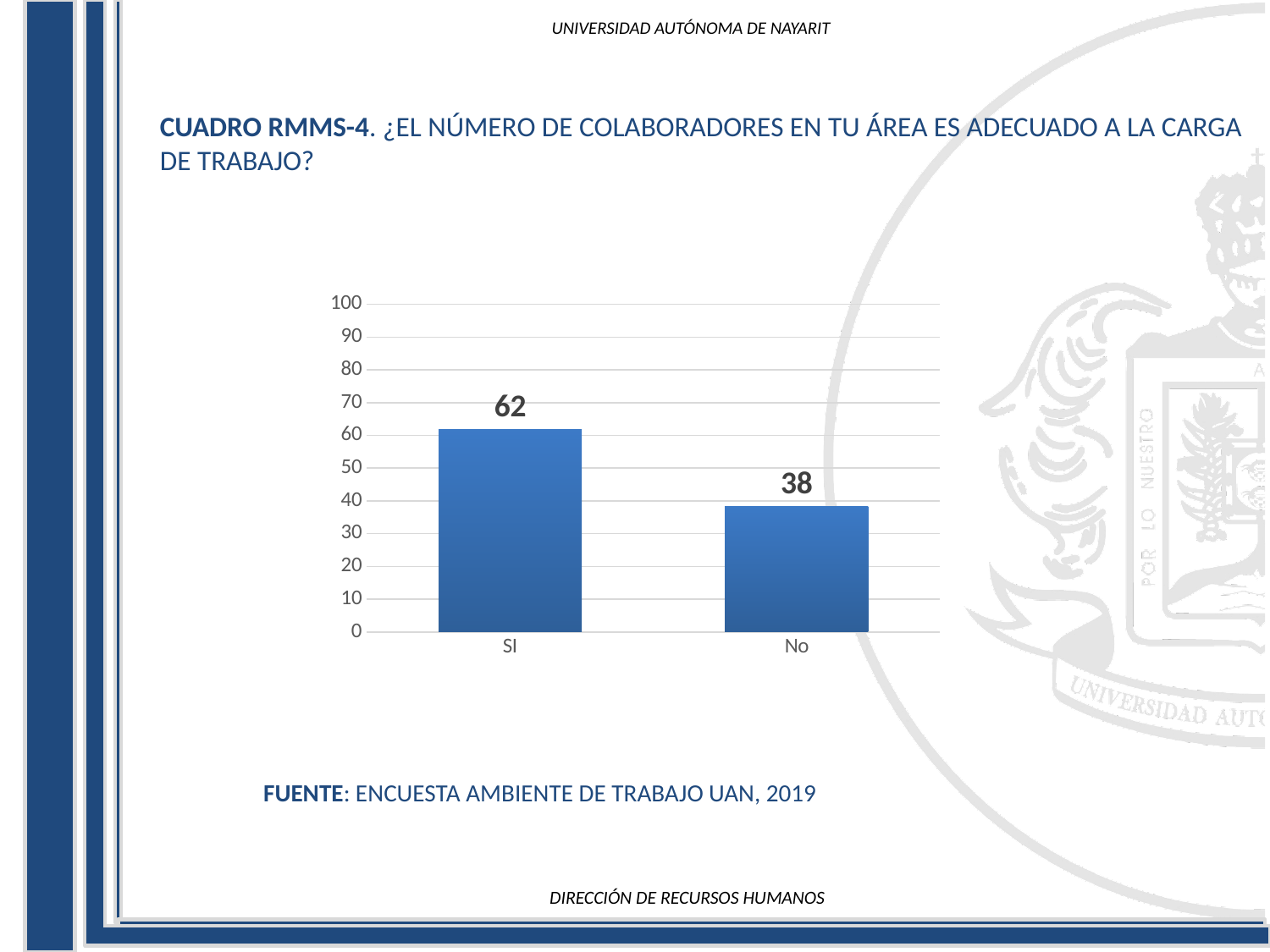
Is the value for No greater or less than 40? less What kind of chart is shown on the slide? bar chart What is the total of the two bar values? 100 Which is larger, the value for SI or the value for No? SI Is the value for SI greater or less than 60? greater What is the maximum value shown on the y axis? 100 Which category has the highest value? SI How many categories are shown on the x axis? 2 Which category has the lowest value? No What is the difference between the values for SI and No? 24 What is the value for SI? 62 What is the value for No? 38